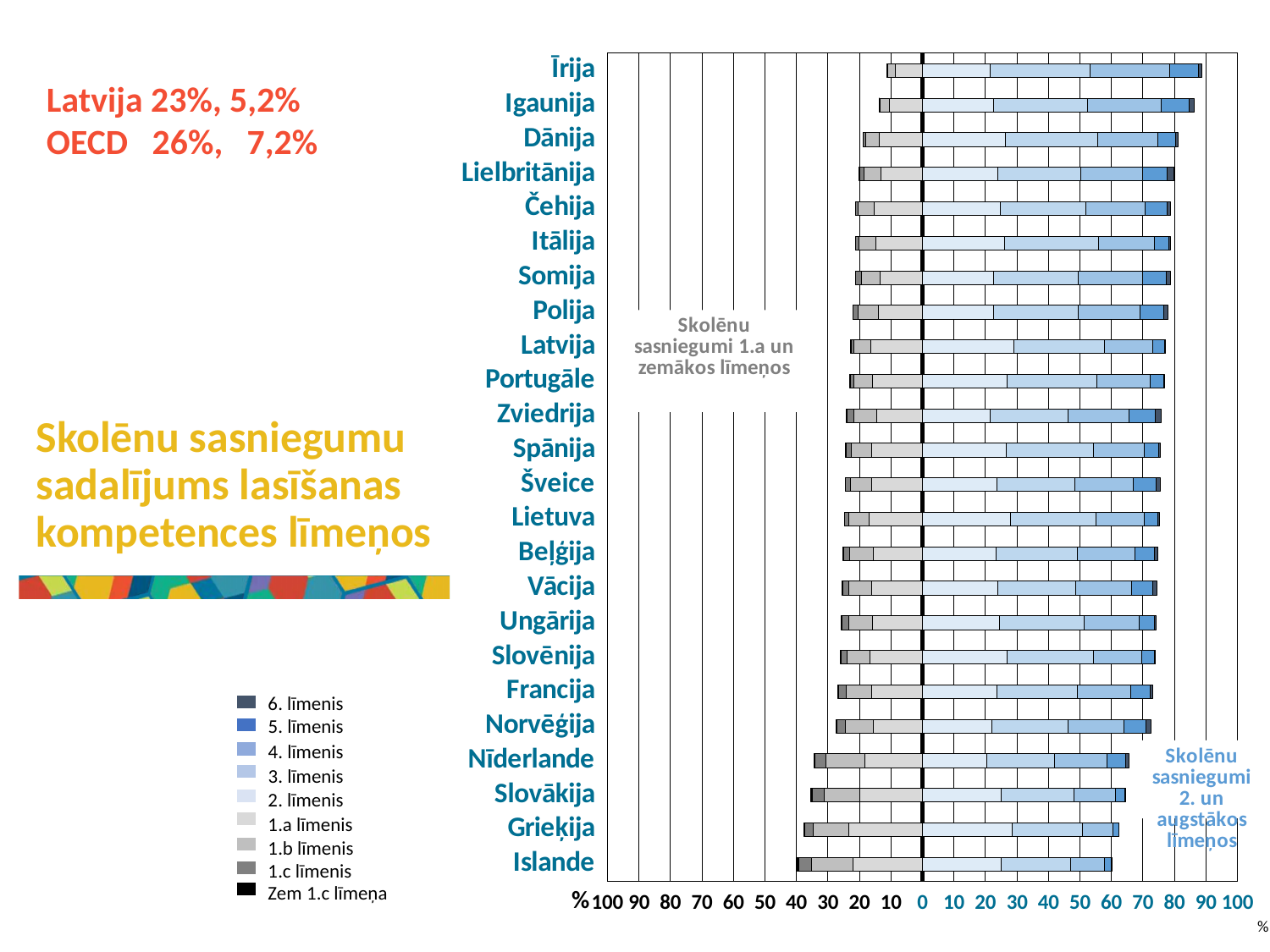
Is the left-side bar (level 1.a and below) for Īrija greater or less than 20? less Which country has the longest bar on the right side (levels 2 and above)? Īrija Which country has the shortest bar on the right side (levels 2 and above)? Islande Which country appears at the top of the chart? Īrija Is the left-side bar (level 1.a and below) for Islande greater or less than 30? greater How many series does the legend list? 9 Is the right-side bar (levels 2 and above) for Islande greater or less than 70? less How many countries are listed on the chart? 24 What kind of chart is shown on the slide? Bar chart Which country appears at the bottom of the chart? Islande Which country has a longer right-side bar (levels 2 and above), Īrija or Islande? Īrija